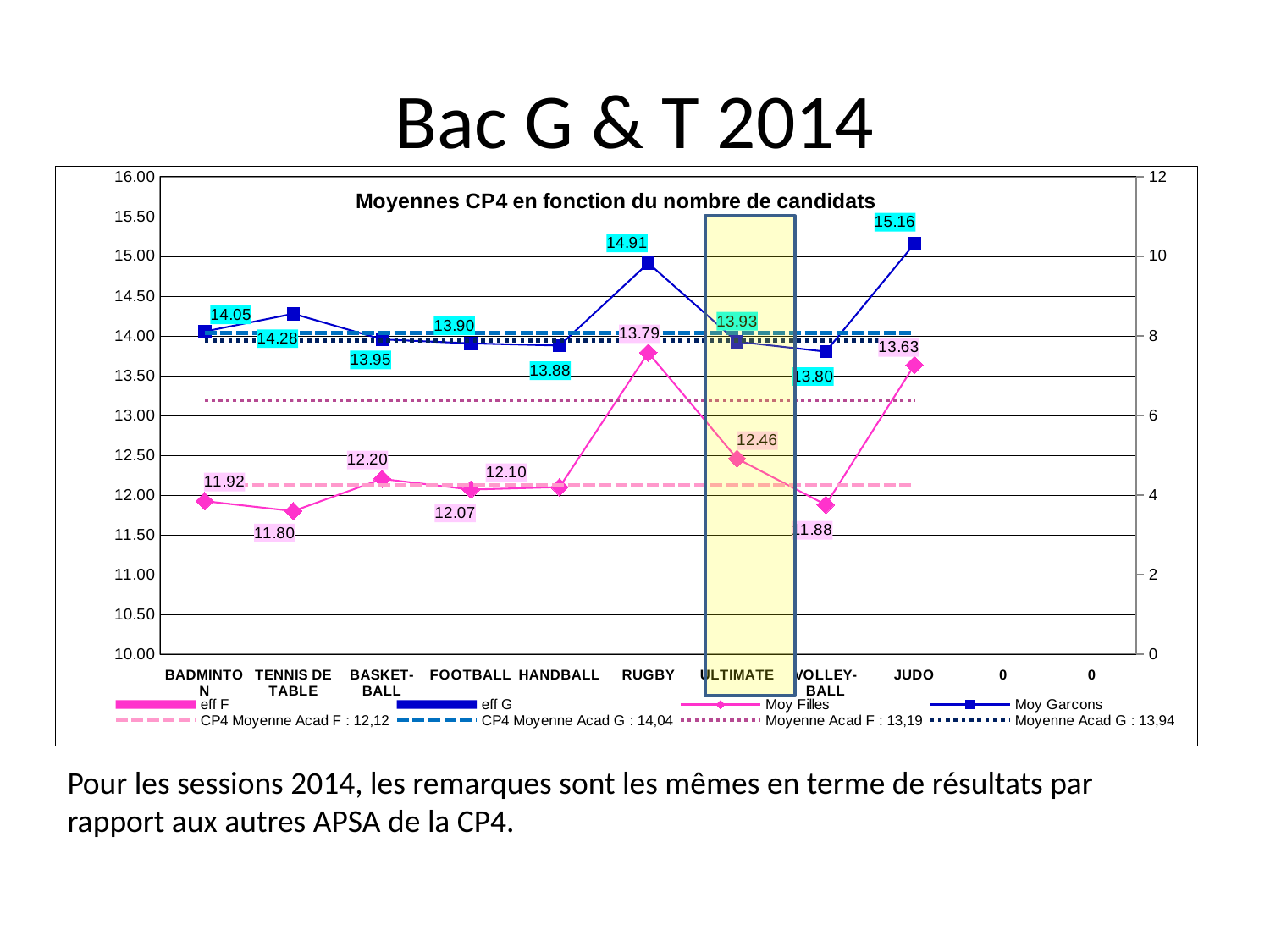
Which category has the highest Moy Garcons value? JUDO What is the Moy Garcons value for RUGBY? 14.91 What is the title of the chart? Moyennes CP4 en fonction du nombre de candidats Is the Moy Filles value for RUGBY greater or less than 13.00? greater What is the difference between the Moy Garcons and Moy Filles values for JUDO? 1.53 What is the Moy Garcons value for VOLLEY-BALL? 13.80 What is the Moy Filles value for TENNIS DE TABLE? 11.80 What value does the legend give for CP4 Moyenne Acad G? 14,04 Which category has the lowest Moy Filles value? TENNIS DE TABLE What is the Moy Filles value for ULTIMATE? 12.46 Which is larger for RUGBY: the Moy Filles value or the Moy Garcons value? Moy Garcons How many entries does the legend list? 8